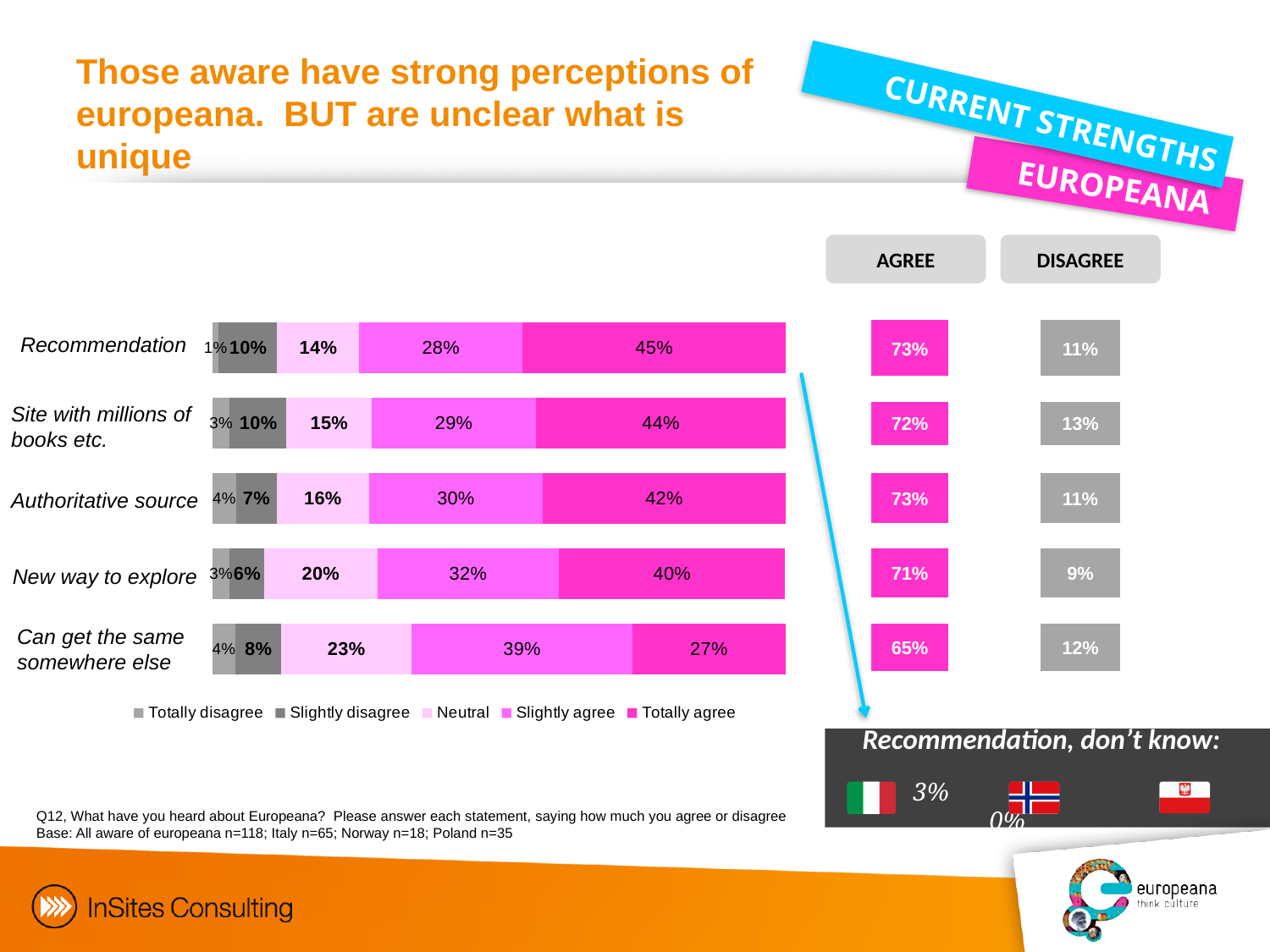
Which statement has the highest Totally agree percentage? Recommendation What type of chart is used to show the agreement levels for each statement? Stacked bar chart What is the Slightly agree value for 'New way to explore'? 32% What is the Neutral value for 'Can get the same somewhere else'? 23% Which has a larger Neutral share: 'Site with millions of books etc.' or 'New way to explore'? New way to explore What percentage of respondents totally agree with the 'Recommendation' statement? 45% How many series does the legend of the stacked bar chart list? 5 Which statement has the lowest Totally agree percentage? Can get the same somewhere else What is the difference in Totally agree percentage between 'Recommendation' and 'Can get the same somewhere else'? 18 percentage points What is the Slightly disagree value for 'Authoritative source'? 7% What is the combined Slightly agree and Totally agree share for 'Authoritative source'? 72% How many statements are shown in the stacked bar chart? 5